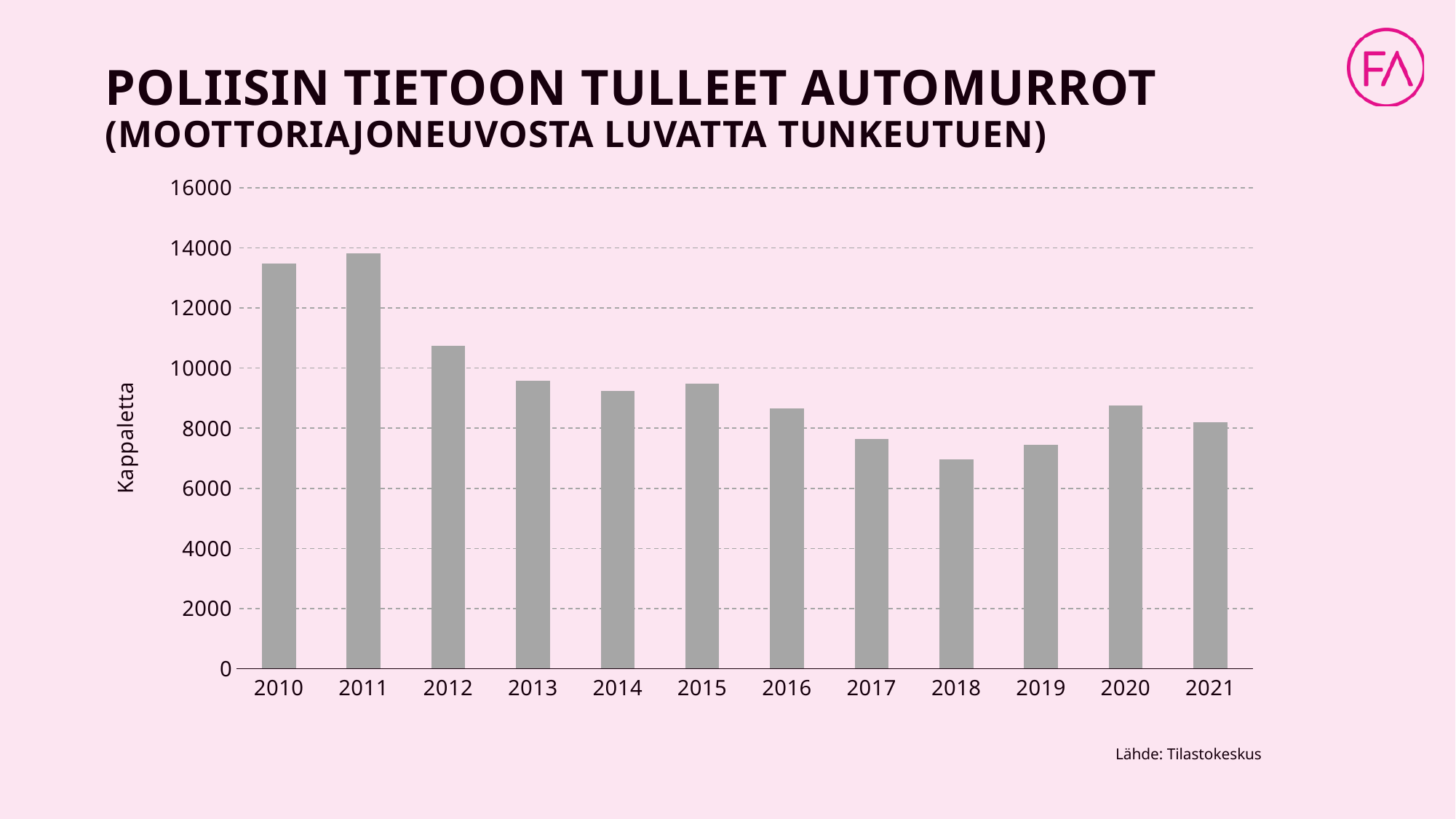
Is the value for 2012 greater or less than 10000? greater What is the label on the vertical axis of the chart? Kappaletta Which year has the lowest number of car break-ins in the chart? 2018 Which year has the larger value, 2019 or 2020? 2020 What kind of chart is shown on the slide? bar chart Overall, do the values rise or fall from 2010 to 2021? fall How many years are shown on the x axis of the chart? 12 Which year has the larger value, 2012 or 2013? 2012 Is the value for 2010 greater or less than 14000? less Is the value for 2020 greater or less than 8000? greater Which year has the highest number of car break-ins in the chart? 2011